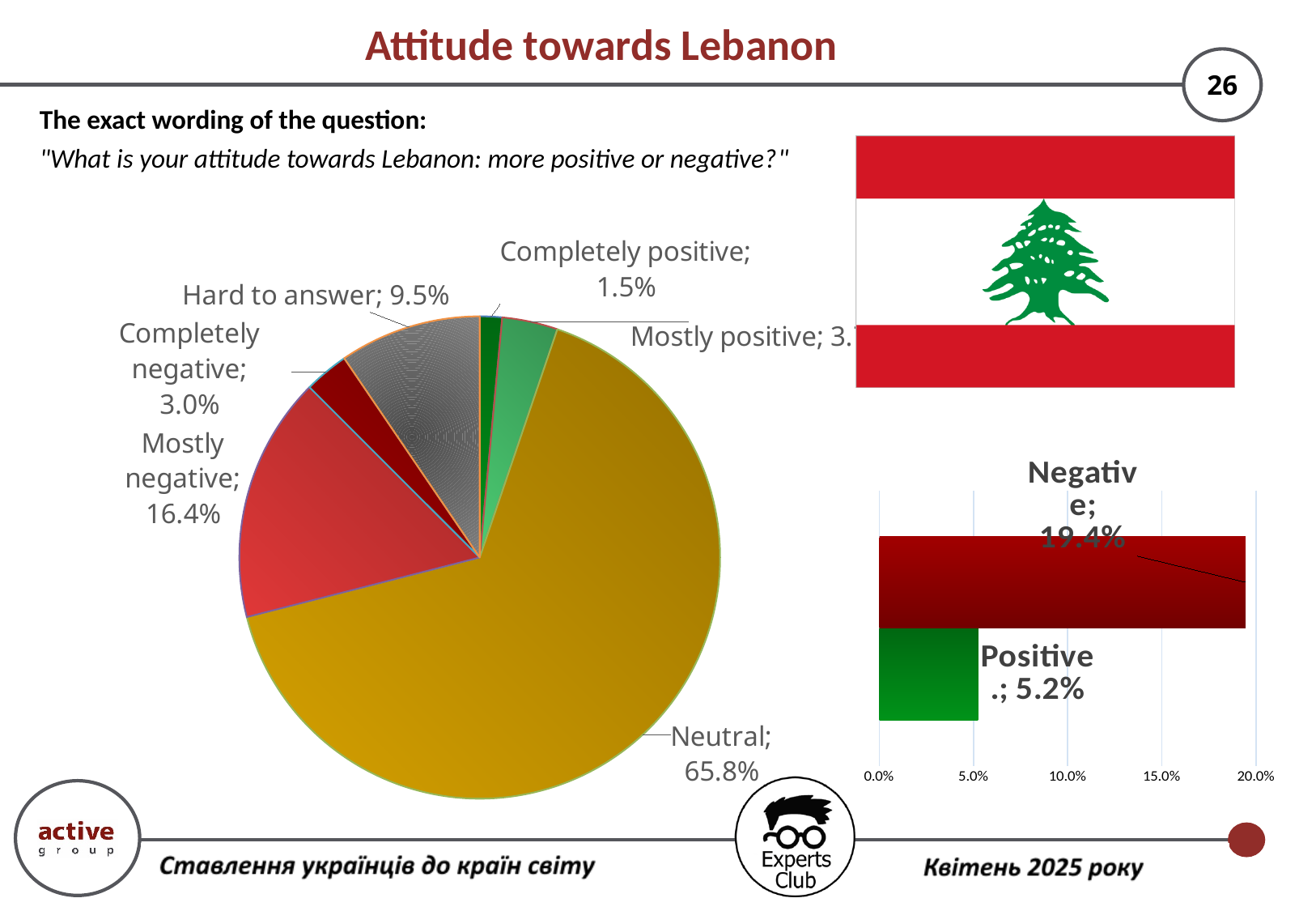
In the pie chart, what is the value for Completely positive? 1.5% In the pie chart, which category has the smallest slice? Completely positive In the bar chart on the right, what is the difference between Negative and Positive? 14.2% What type of chart is shown on the right side of the slide below the flag? Bar chart In the pie chart, how much larger is Mostly negative than Hard to answer? 6.9% In the pie chart, what is the value for Mostly negative? 16.4% In the bar chart on the right, what is the value for Positive? 5.2% In the pie chart, what percentage of respondents answered Neutral? 65.8% In the pie chart, what is the value for Completely negative? 3.0% In the pie chart, what share of respondents found it Hard to answer? 9.5% In the bar chart on the right, what is the value for Negative? 19.4% In the pie chart, which category has the largest slice? Neutral